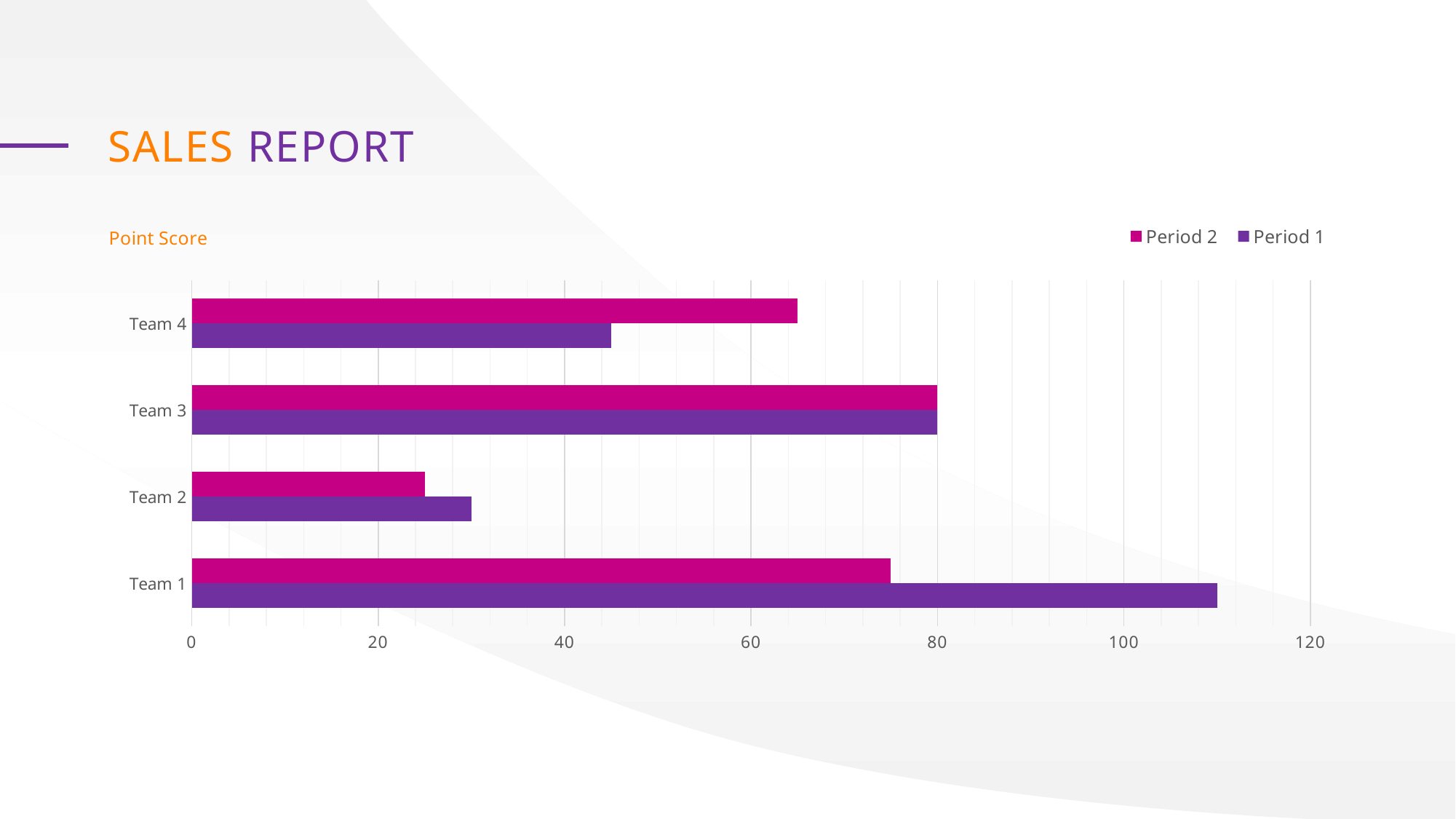
Which team has the highest Period 2 value? Team 3 Is the Period 1 value for Team 1 greater or less than 100? greater Which team has the highest Period 1 value? Team 1 What kind of chart is shown on the slide? bar chart For Team 2, which is larger: the Period 1 value or the Period 2 value? Period 1 How many series does the chart legend list? 2 Which team has the lowest Period 2 value? Team 2 How many teams are shown on the chart? 4 For Team 4, which is larger: the Period 1 value or the Period 2 value? Period 2 What is the Period 2 value for Team 3? 80 Which team has the lowest Period 1 value? Team 2 Is the Period 2 value for Team 4 greater or less than 60? greater